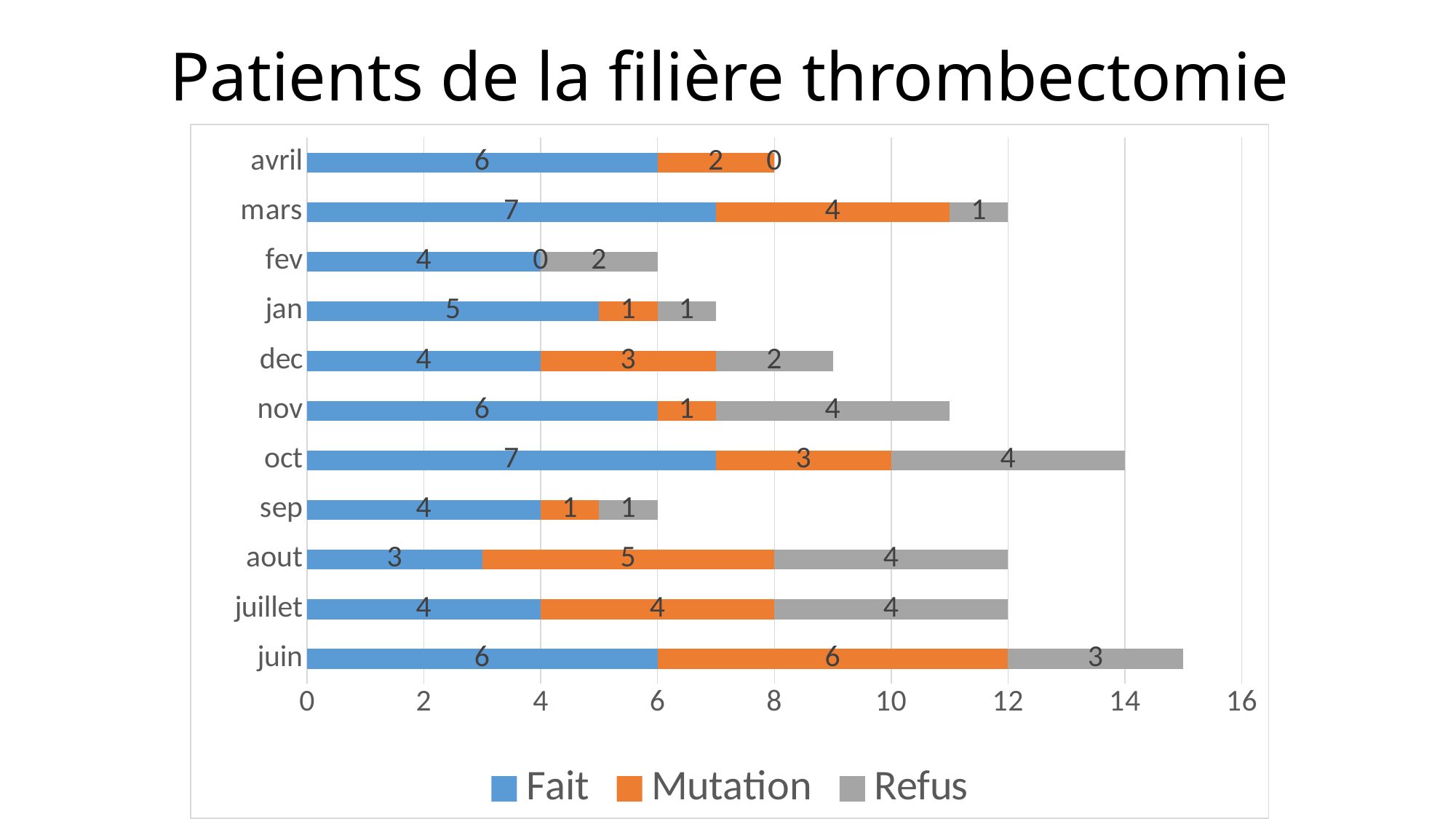
Which month has the highest Mutation value? juin What is the Mutation value for aout? 5 How many months are shown on the chart? 11 What kind of chart is shown on the slide? Stacked bar chart What is the total of the stacked bar for juin? 15 What is the Fait value for mars? 7 What is the total of the stacked bar for dec? 9 Which month has the lowest Fait value? aout How many series does the legend list? 3 What is the difference between the Fait value for mars and the Fait value for fev? 3 Which is larger, the Refus value for nov or the Refus value for jan? nov What is the Refus value for oct? 4